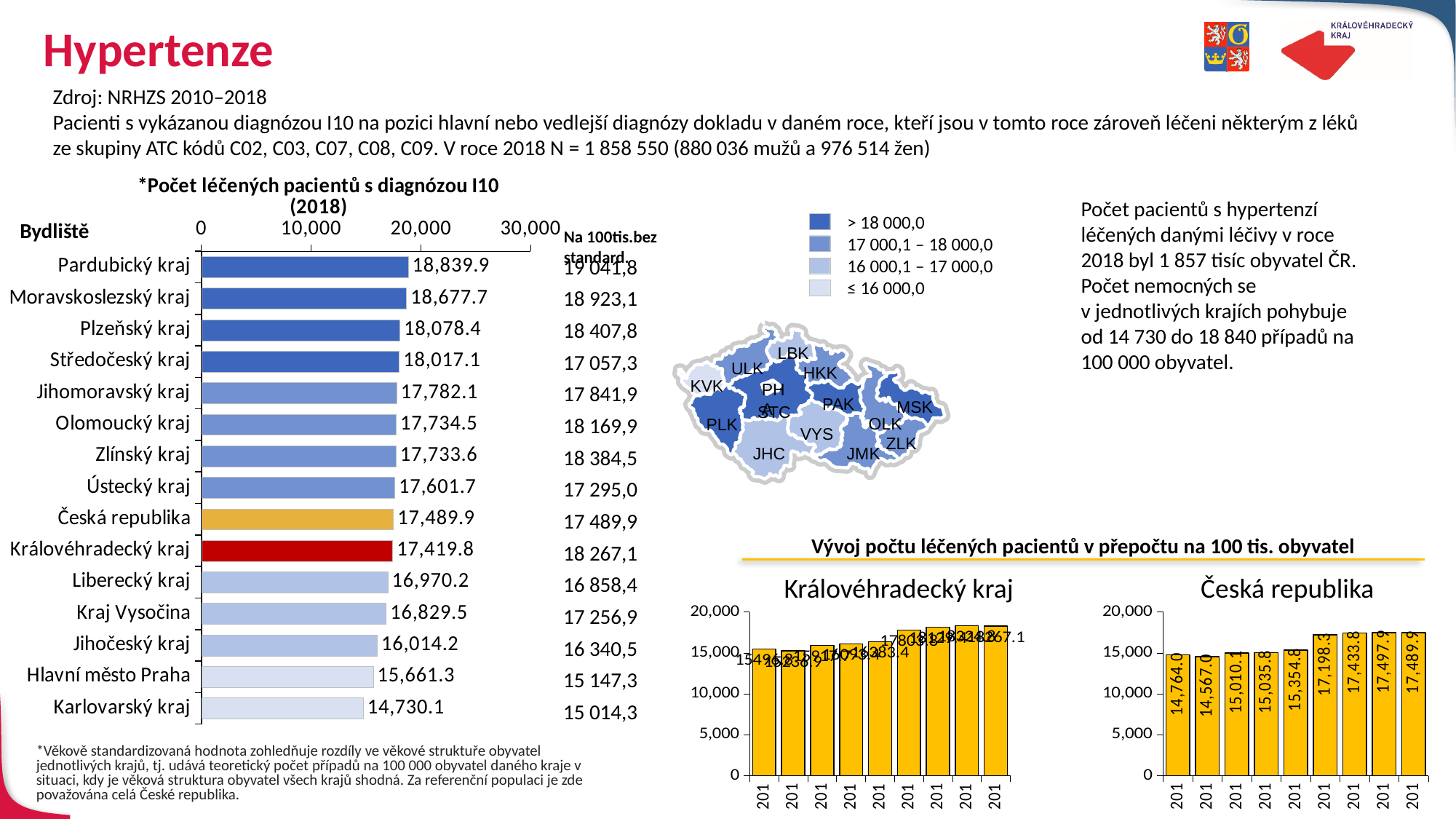
In the chart '*Počet léčených pacientů s diagnózou I10 (2018)', what is the value for Česká republika? 17,489.9 In the chart '*Počet léčených pacientů s diagnózou I10 (2018)', what colour is the bar for Královéhradecký kraj? red In the 'Královéhradecký kraj' chart at the bottom, is the value of the rightmost bar greater or less than 15,000? greater In the chart '*Počet léčených pacientů s diagnózou I10 (2018)', how many bars are plotted? 15 In the chart '*Počet léčených pacientů s diagnózou I10 (2018)', what is the difference between Pardubický kraj and Karlovarský kraj? 4,109.8 In the chart '*Počet léčených pacientů s diagnózou I10 (2018)', what is the value for Královéhradecký kraj? 17,419.8 In the chart '*Počet léčených pacientů s diagnózou I10 (2018)', which region has the highest value? Pardubický kraj What kind of chart is '*Počet léčených pacientů s diagnózou I10 (2018)'? bar chart In the chart '*Počet léčených pacientů s diagnózou I10 (2018)', which region has the lowest value? Karlovarský kraj In the 'Česká republika' chart at the bottom right, do the values generally rise or fall from left to right? rise In the chart '*Počet léčených pacientů s diagnózou I10 (2018)', which is larger: Liberecký kraj or Kraj Vysočina? Liberecký kraj In the 'Česká republika' chart at the bottom right, what is the value of the last (rightmost) bar? 17,489.9